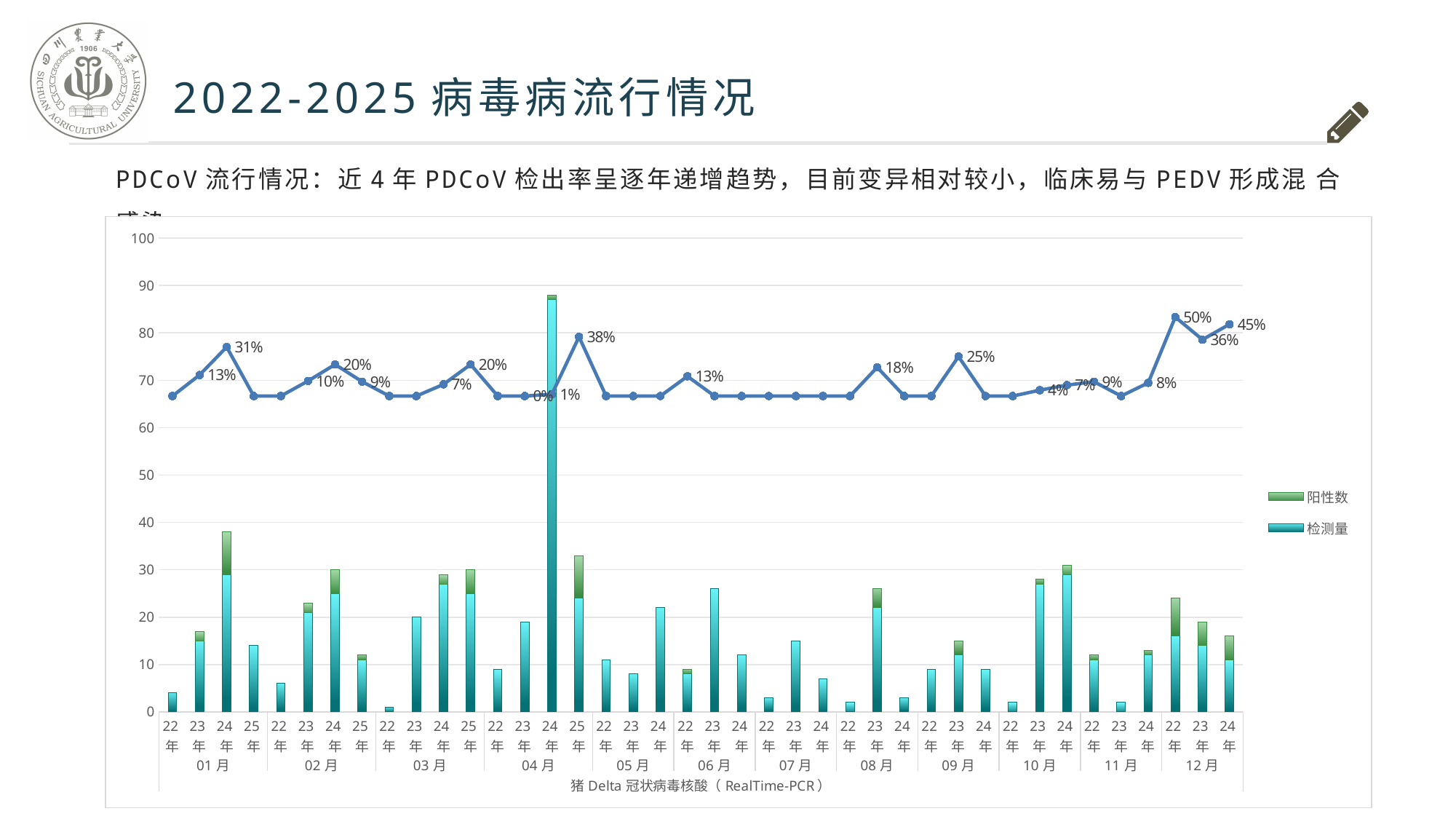
Is the total bar height for 22年 in 03月 greater or less than 10? less In 01月, which year has the larger percentage label, 23年 or 24年? 24年 Is the total bar height for 24年 in 04月 greater or less than 80? greater How many series does the legend list? 2 What is the difference between the percentage labels for 22年 and 23年 in 12月? 14% What are the two series names listed in the legend? 阳性数 and 检测量 What is the percentage label shown for 25年 in 04月? 38% How many months are shown along the x axis? 12 What is the percentage label shown for 24年 in 01月? 31% Which month and year has the highest percentage label on the line? 12月 22年 (50%) What is the percentage label shown for 22年 in 12月? 50% What is the percentage label shown for 23年 in 09月? 25%